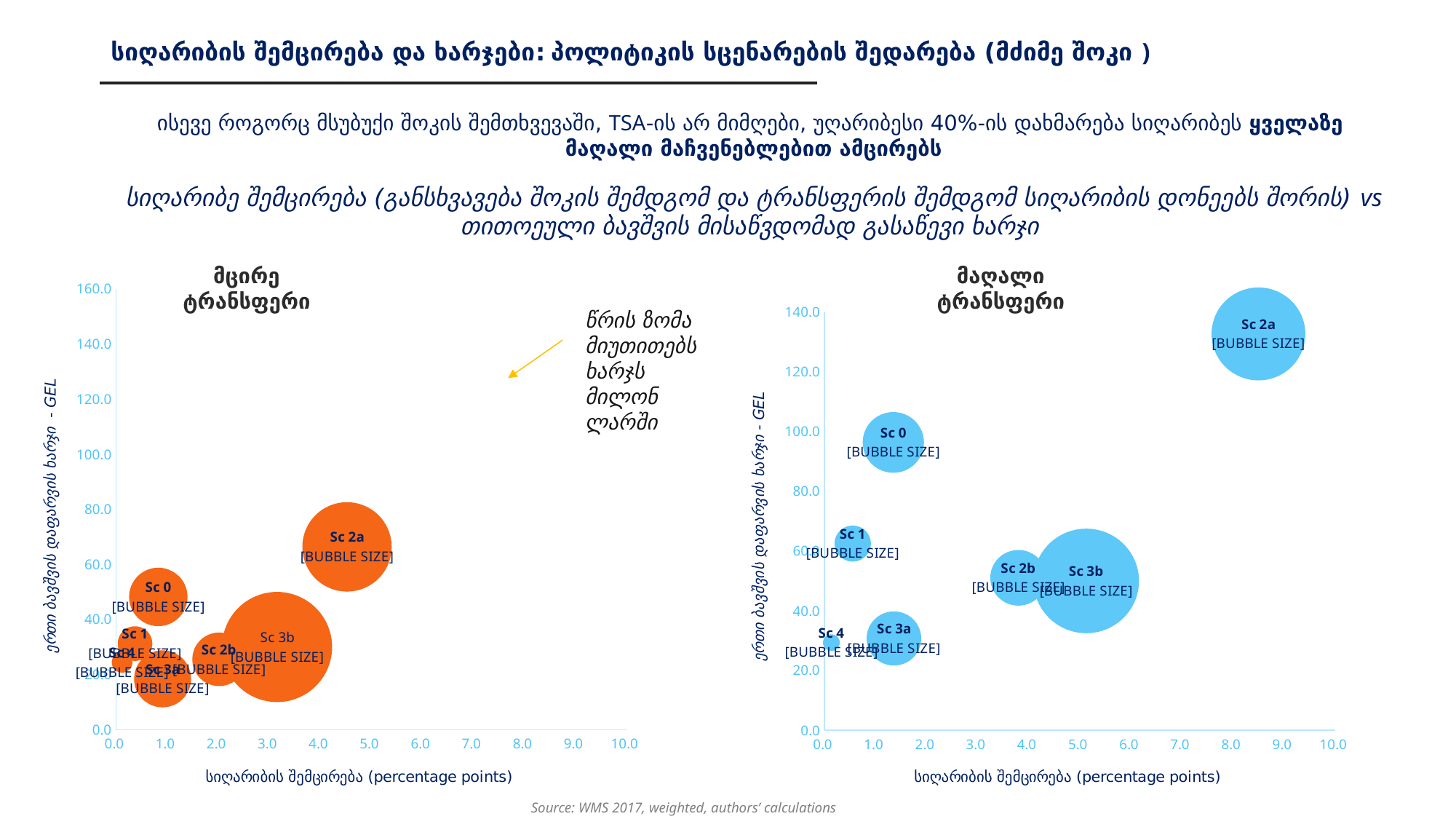
In the left chart (მცირე ტრანსფერი), which scenario has the highest value on the vertical axis? Sc 2a What kind of chart is shown on the left side of the slide? bubble chart In the right chart (მაღალი ტრანსფერი), which scenario is furthest to the right on the horizontal axis? Sc 2a In the left chart (მცირე ტრანსფერი), how many scenario bubbles are plotted? 7 In the right chart (მაღალი ტრანსფერი), is the vertical-axis value for Sc 0 greater or less than 80.0? greater In the left chart (მცირე ტრანსფერი), is the horizontal-axis value for Sc 2a greater or less than 4.0? greater In the left chart (მცირე ტრანსფერი), is the vertical-axis value for Sc 3b greater or less than 40.0? less In the right chart (მაღალი ტრანსფერი), which has the higher vertical-axis value, Sc 0 or Sc 1? Sc 0 What is the title shown above the left chart? მცირე ტრანსფერი In the right chart (მაღალი ტრანსფერი), which scenario has the highest value on the vertical axis? Sc 2a